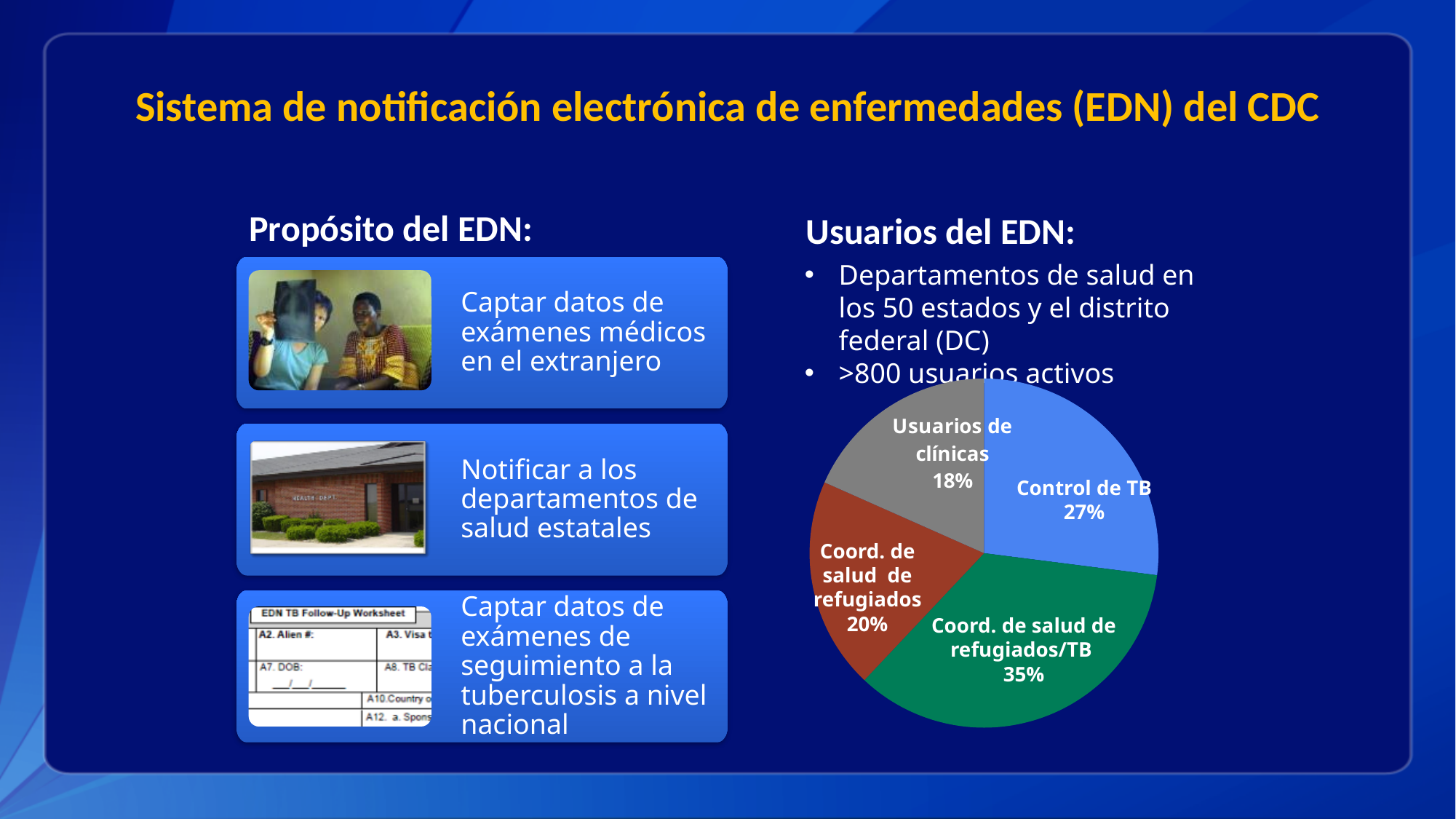
What share of the pie does Control de TB represent? 27% How many slices does the pie chart have? 4 What is the difference in percentage points between Coord. de salud de refugiados and Usuarios de clínicas? 2 Which slice of the pie chart is the largest? Coord. de salud de refugiados/TB What share of the pie does Usuarios de clínicas represent? 18% What share of the pie does Coord. de salud de refugiados/TB represent? 35% What is the difference in percentage points between Coord. de salud de refugiados/TB and Control de TB? 8 What colour is the Coord. de salud de refugiados/TB slice? green Which is larger: Control de TB or Coord. de salud de refugiados? Control de TB What kind of chart is shown on the slide? pie chart Which slice of the pie chart is the smallest? Usuarios de clínicas